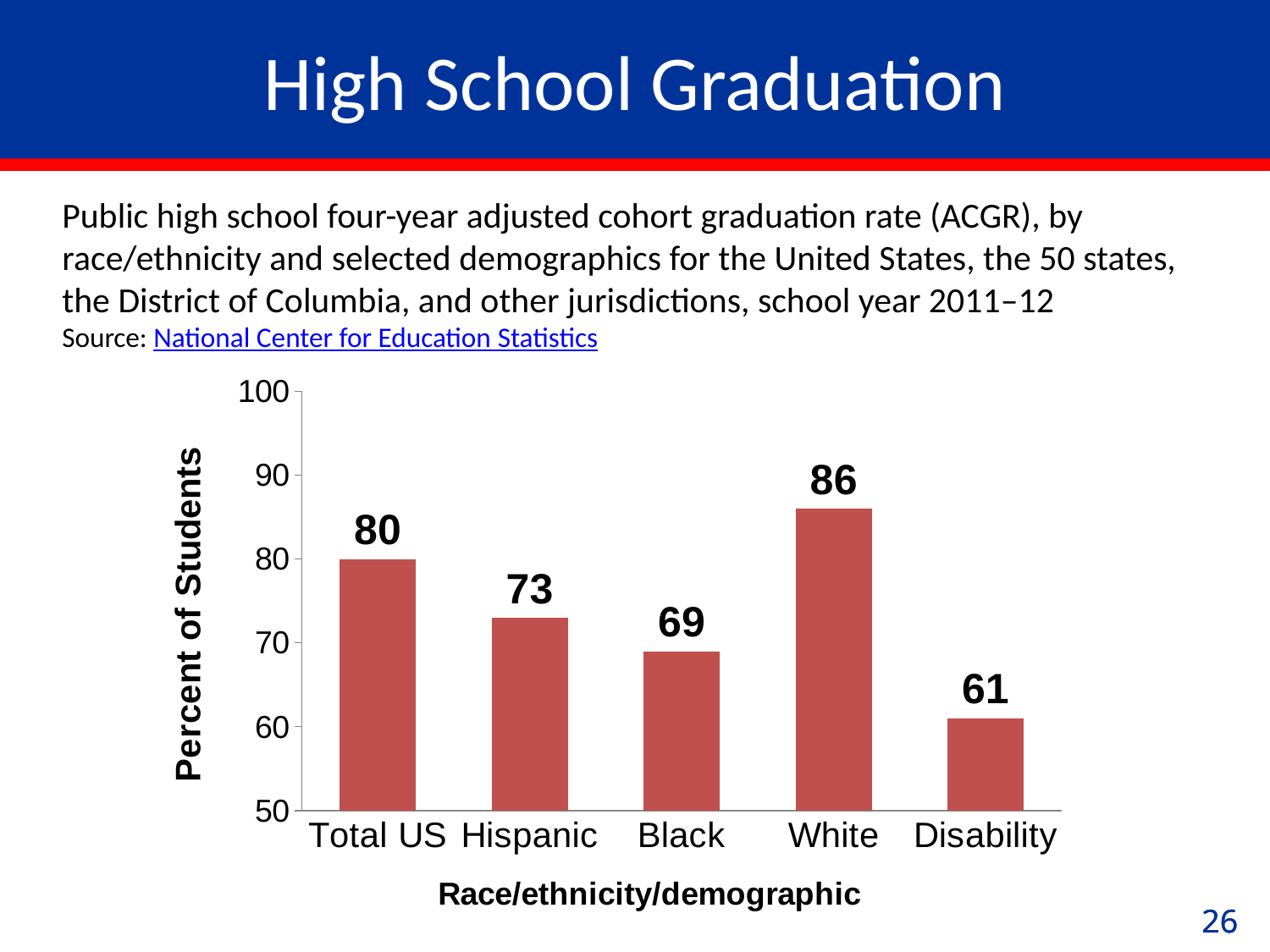
What is the label of the y axis? Percent of Students Which category has the highest graduation rate? White What is the value for Total US? 80 What is the graduation rate for Hispanic students? 73 What is the value shown for the Disability category? 61 What is the difference between the White and Black graduation rates? 17 Is the value for Black greater or less than 70? less Which category has the lowest graduation rate? Disability How much higher is the Total US rate than the Disability rate? 19 Which is larger, the value for Hispanic or the value for Black? Hispanic How many categories are shown on the x axis? 5 What kind of chart is shown on the slide? bar chart